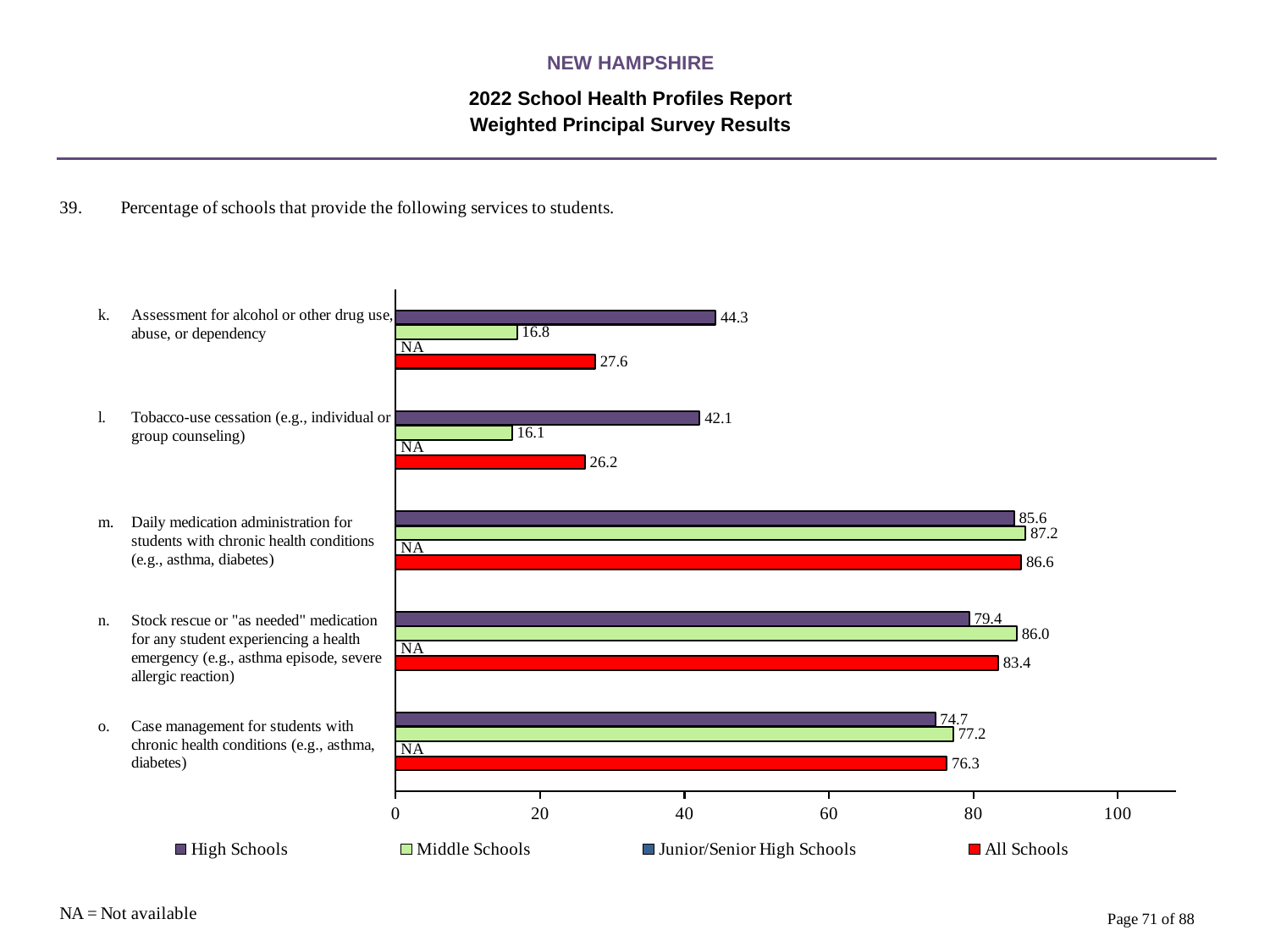
For case management for students with chronic health conditions, which is larger: the High Schools value or the Middle Schools value? Middle Schools What is the difference between the High Schools and Middle Schools values for stock rescue or "as needed" medication? 6.6 Which service has the lowest value for Middle Schools? Tobacco-use cessation (e.g., individual or group counseling) What type of chart is shown on the slide? bar chart Which service has the highest value for High Schools? Daily medication administration for students with chronic health conditions How many services (categories) are shown on the chart? 5 What is the value for Junior/Senior High Schools for case management for students with chronic health conditions? NA Is the All Schools value for tobacco-use cessation greater or less than 40? less How many series does the legend list? 4 What percentage of high schools provide assessment for alcohol or other drug use, abuse, or dependency? 44.3 What is the value for Middle Schools for tobacco-use cessation (e.g., individual or group counseling)? 16.1 What is the All Schools value for daily medication administration for students with chronic health conditions? 86.6